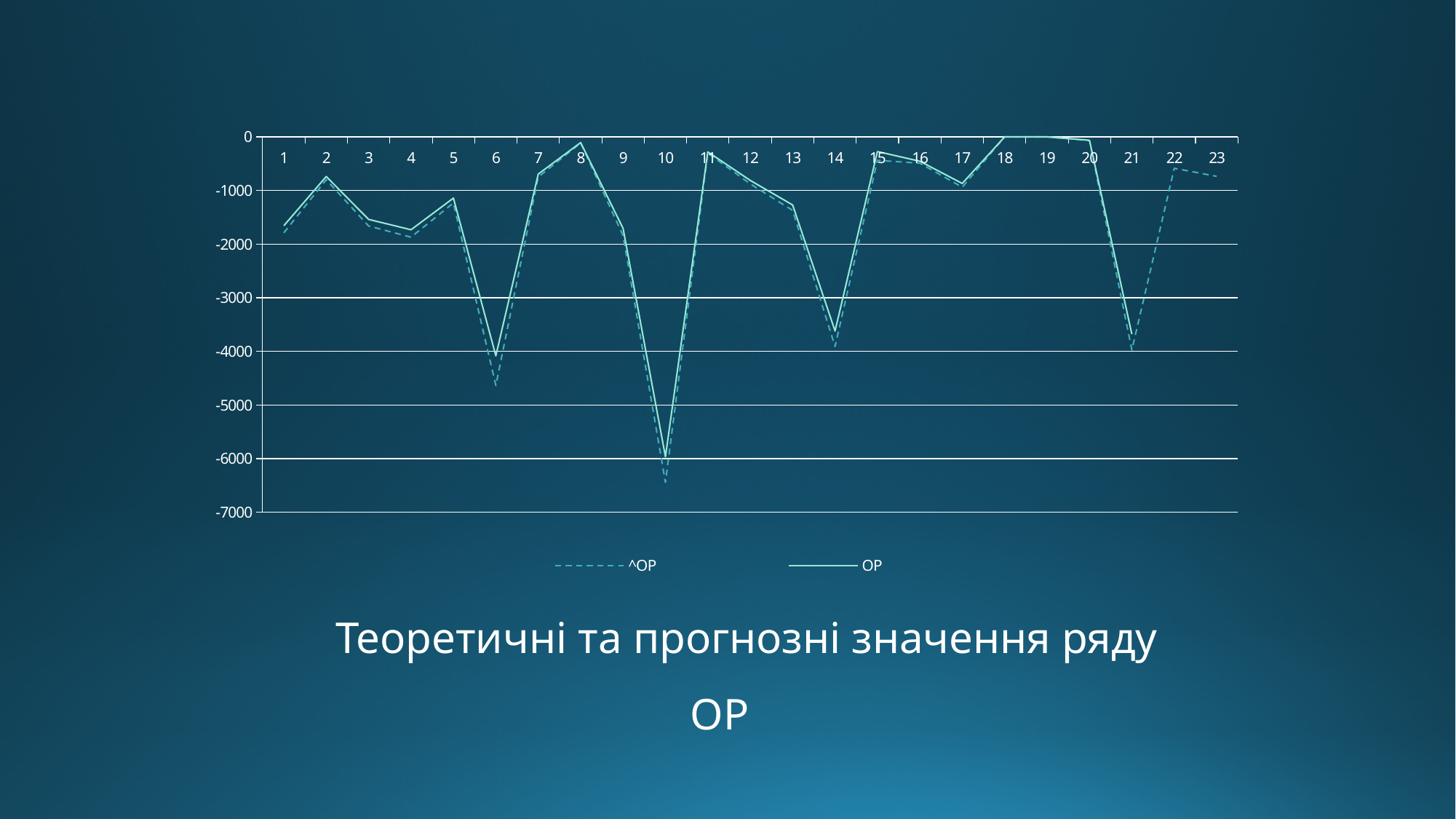
Which series is drawn with a dashed line? ^OP Is the value of the OP series at point 8 greater or less than -1000? greater Which is larger for the OP series: the value at point 6 or the value at point 10? point 6 What are the two series named in the legend? ^OP and OP Does the OP series rise or fall from point 9 to point 10? fall What kind of chart is shown on the slide? line chart At which x-axis point does the OP series reach its lowest value? 10 Is the value of the OP series at point 14 greater or less than -3000? less Is the value of the ^OP series at point 6 greater or less than -4000? less How many series does the legend list? 2 How many points are labelled along the x axis? 23